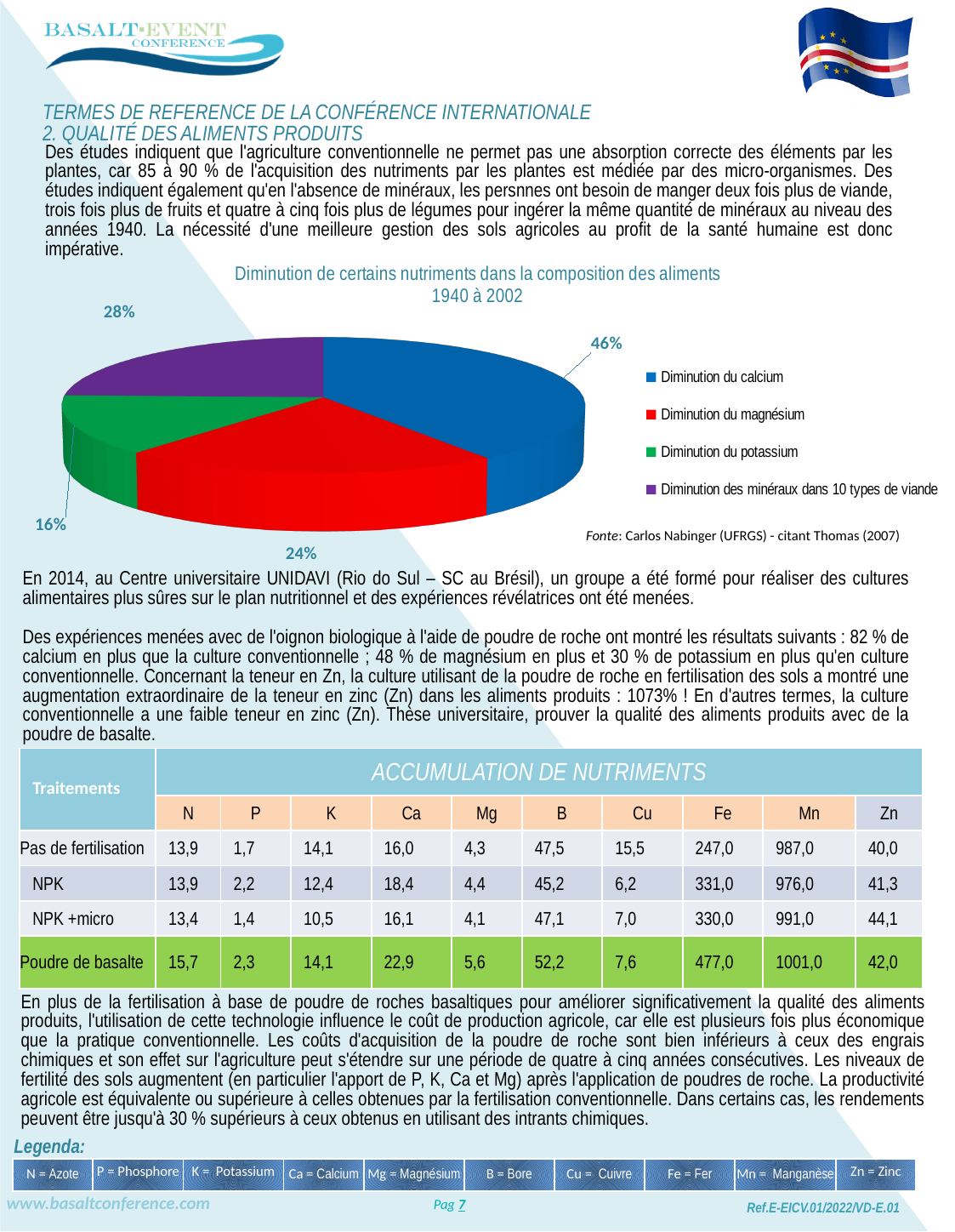
In the pie chart, which is larger: the slice for 'Diminution du magnésium' or the slice for 'Diminution des minéraux dans 10 types de viande'? Diminution des minéraux dans 10 types de viande Which category has the largest slice in the pie chart? Diminution du calcium Which category has the smallest slice in the pie chart? Diminution du potassium What percentage is shown for 'Diminution du calcium' in the pie chart? 46% How many slices does the pie chart have? 4 What type of chart is shown on the slide? Pie chart How many entries does the legend of the pie chart list? 4 What percentage is shown for 'Diminution du potassium' in the pie chart? 16% What is the difference between the percentages for 'Diminution du calcium' and 'Diminution du magnésium' in the pie chart? 22% What percentage is shown for 'Diminution du magnésium' in the pie chart? 24% What colour is the slice for 'Diminution du potassium' in the pie chart? Green What percentage is shown for 'Diminution des minéraux dans 10 types de viande' in the pie chart? 28%